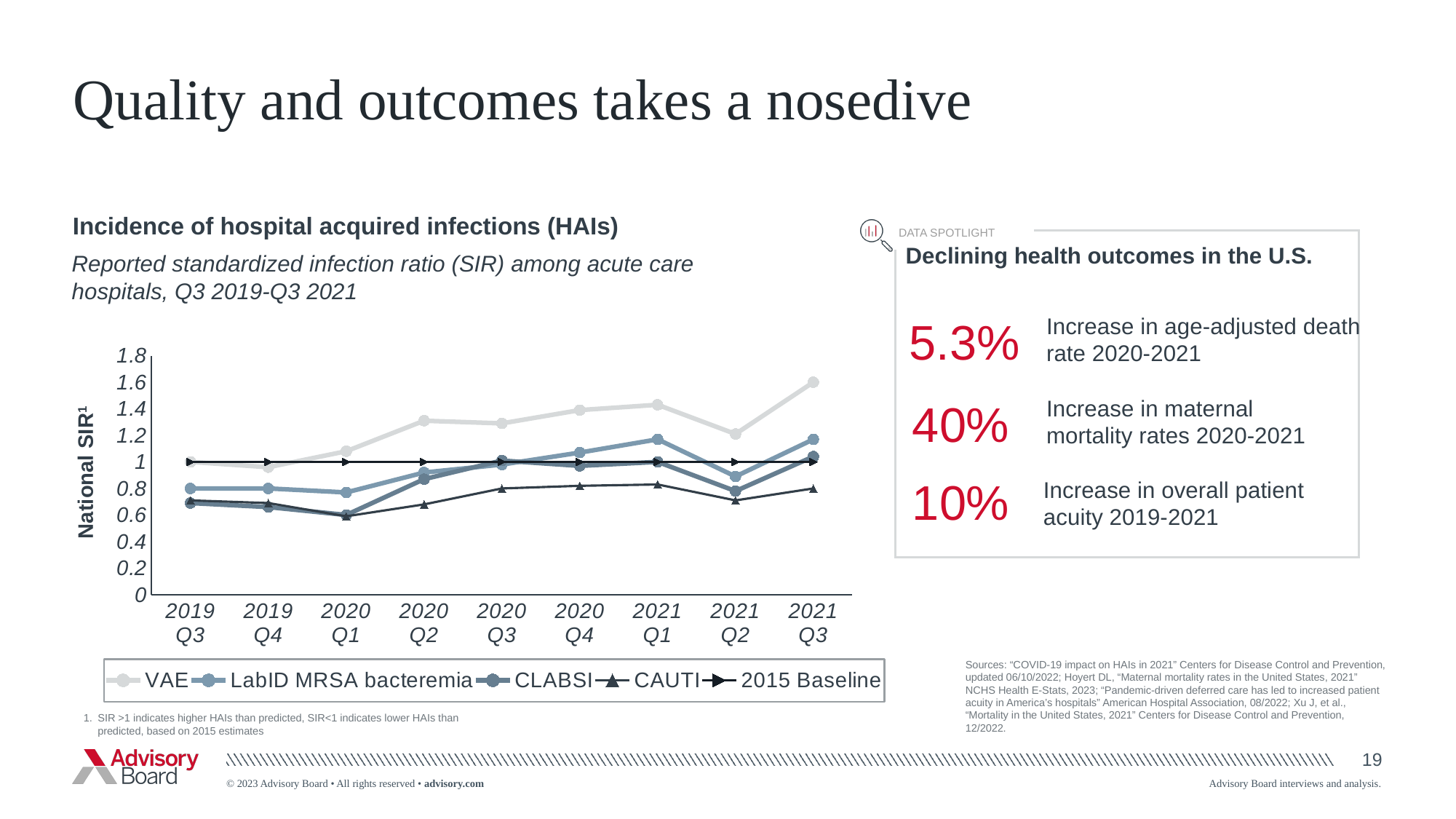
What value does the 2015 Baseline series sit at across the chart? 1 Is the value for CAUTI at 2020 Q1 greater or less than 0.8? less What is the label on the y axis of the chart? National SIR Is the value for VAE at 2021 Q3 greater or less than 1.4? greater Is the value for LabID MRSA bacteremia at 2021 Q1 greater or less than 1? greater In which quarter does the VAE series reach its highest value? 2021 Q3 How many quarters are plotted along the x axis of the chart? 9 What kind of chart is shown on the slide? line chart Which series has the lowest value at 2021 Q3? CAUTI Does the VAE series rise or fall overall from 2019 Q3 to 2021 Q3? rise Which series has the highest value at 2021 Q3? VAE How many series does the chart legend list? 5